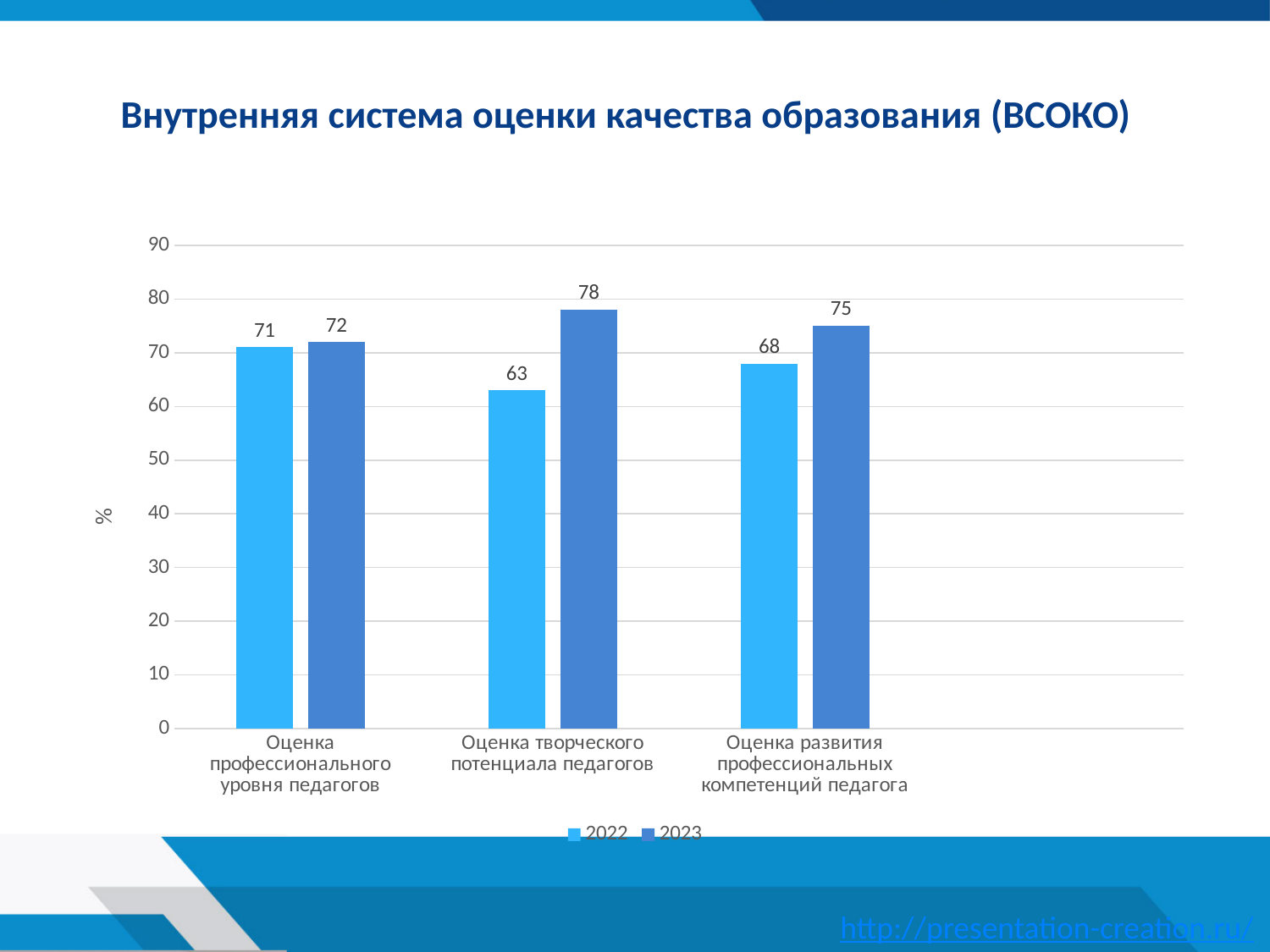
What is the difference between the 2023 and 2022 values for 'Оценка творческого потенциала педагогов'? 15 What kind of chart is shown on the slide? Bar chart What is the 2023 value for 'Оценка творческого потенциала педагогов'? 78 Which category has the lowest 2022 value? Оценка творческого потенциала педагогов How many series does the legend list? 2 Which category has the highest 2023 value? Оценка творческого потенциала педагогов What is the 2022 value for 'Оценка профессионального уровня педагогов'? 71 What is the 2022 value for 'Оценка развития профессиональных компетенций педагога'? 68 What is the difference between the 2023 and 2022 values for 'Оценка развития профессиональных компетенций педагога'? 7 What is the label on the vertical axis? % Which is larger: the 2022 value for 'Оценка профессионального уровня педагогов' or the 2022 value for 'Оценка творческого потенциала педагогов'? Оценка профессионального уровня педагогов How many categories are shown on the x axis? 3